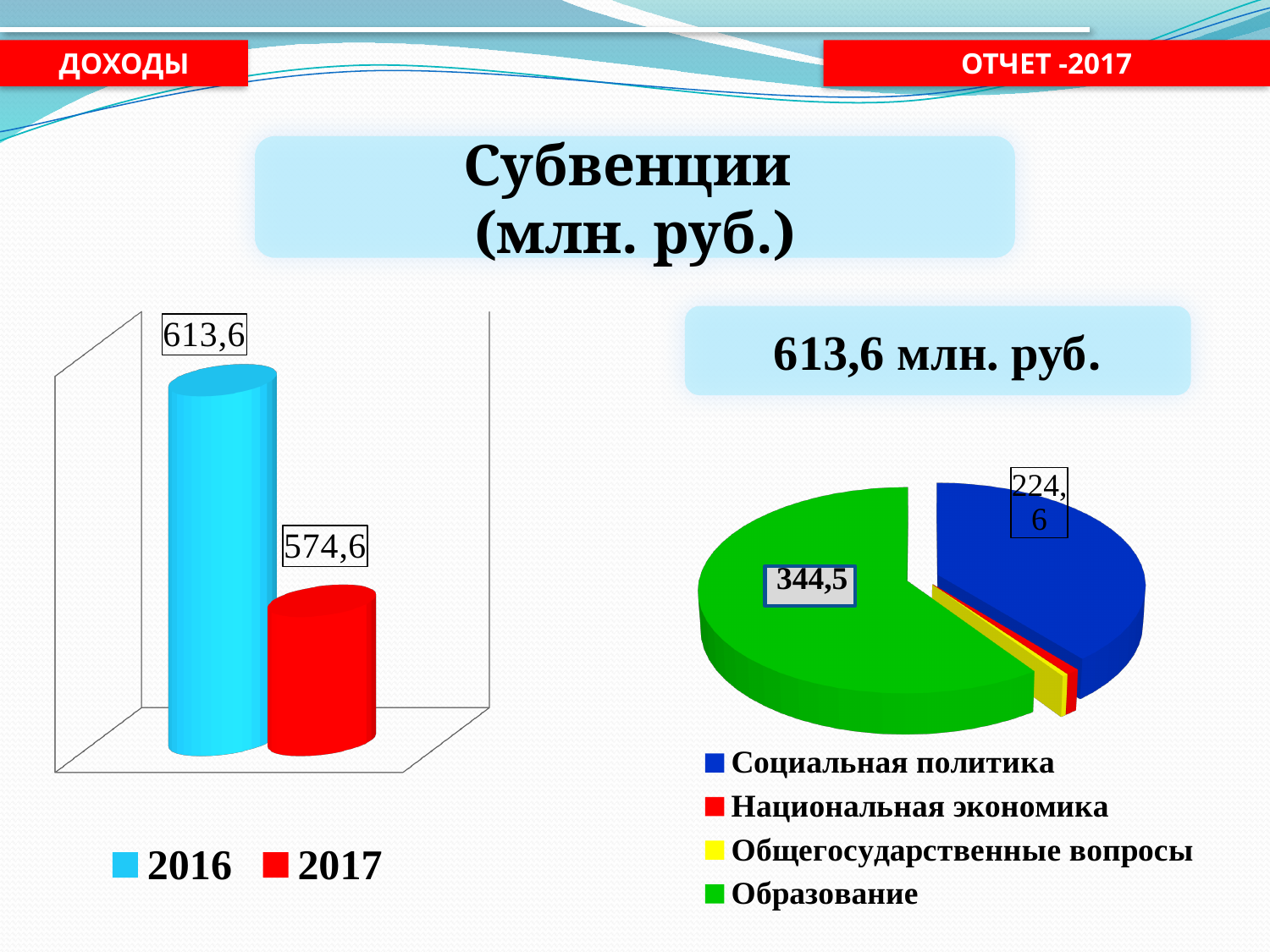
In the bar chart on the left, which year has the higher value, 2016 or 2017? 2016 In the pie chart on the right, what is the value for Образование? 344,5 In the bar chart on the left, does the value rise or fall from 2016 to 2017? fall How many categories does the legend of the pie chart on the right list? 4 In the bar chart on the left, what is the difference between the 2016 and 2017 values? 39,0 In the pie chart on the right, what is the value for Социальная политика? 224,6 In the bar chart on the left, what is the value for 2017? 574,6 In the pie chart on the right, what colour represents Образование? green In the pie chart on the right, which category has the largest slice? Образование What kind of chart is the chart on the left of the slide? bar chart How many series does the legend of the bar chart on the left list? 2 In the bar chart on the left, what is the value for 2016? 613,6